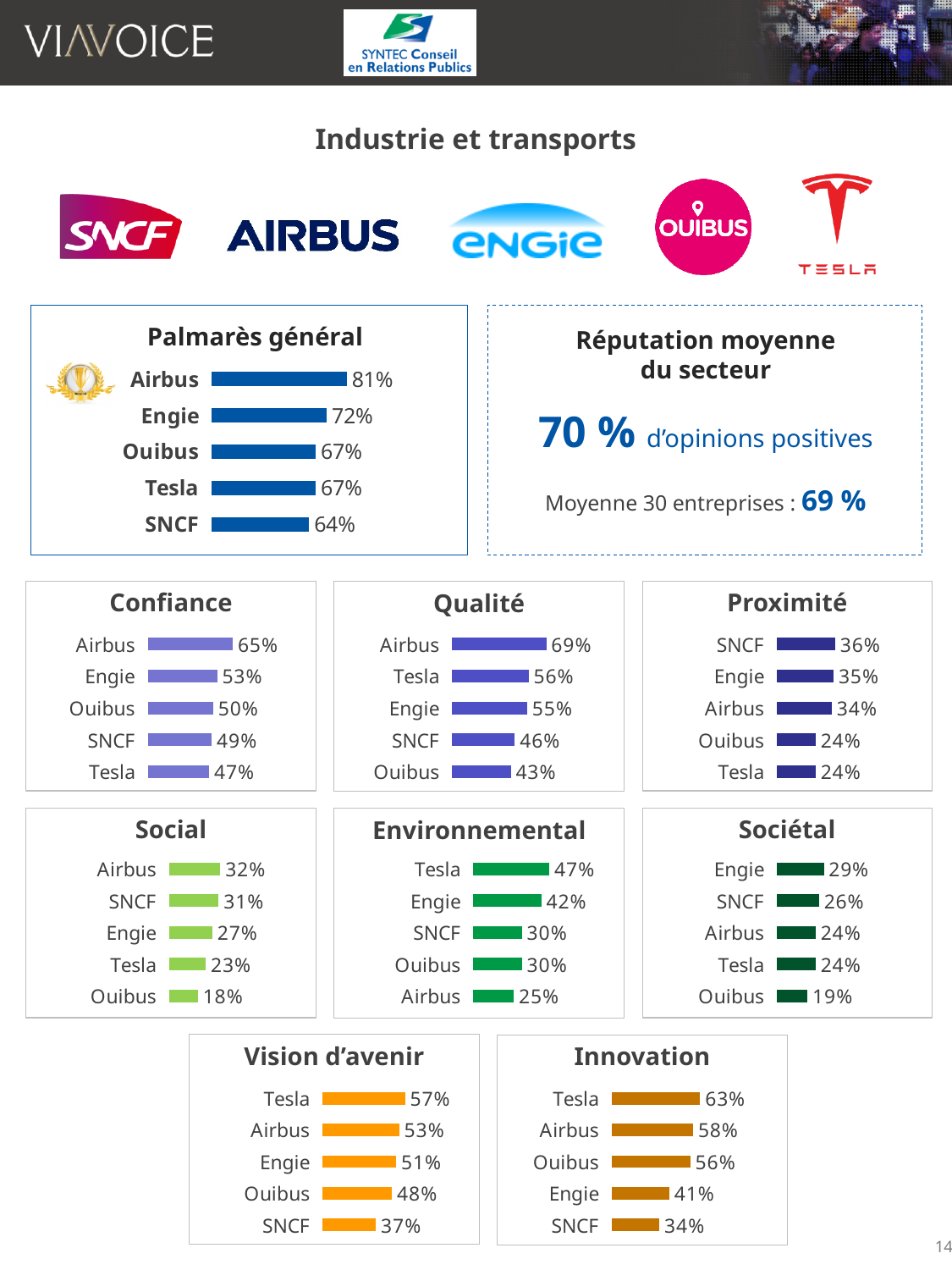
In the 'Vision d'avenir' chart, what is the difference between Tesla and SNCF? 20% In the 'Confiance' chart, what is the difference between Airbus and Tesla? 18% In the 'Sociétal' chart, which company has the lowest value? Ouibus In the 'Palmarès général' chart, what is the value for Airbus? 81% In the 'Proximité' chart, what is the value for Engie? 35% In the 'Environnemental' chart, what is the value for Tesla? 47% What kind of chart is the 'Innovation' chart? Bar chart How many charts with the title 'Palmarès général' or a category name are shown on the slide? 9 In the 'Qualité' chart, which company has the highest value? Airbus In the 'Social' chart, which is larger, the value for SNCF or the value for Ouibus? SNCF In the 'Palmarès général' chart, which company has the lowest value? SNCF In the 'Innovation' chart, how many companies are shown? 5